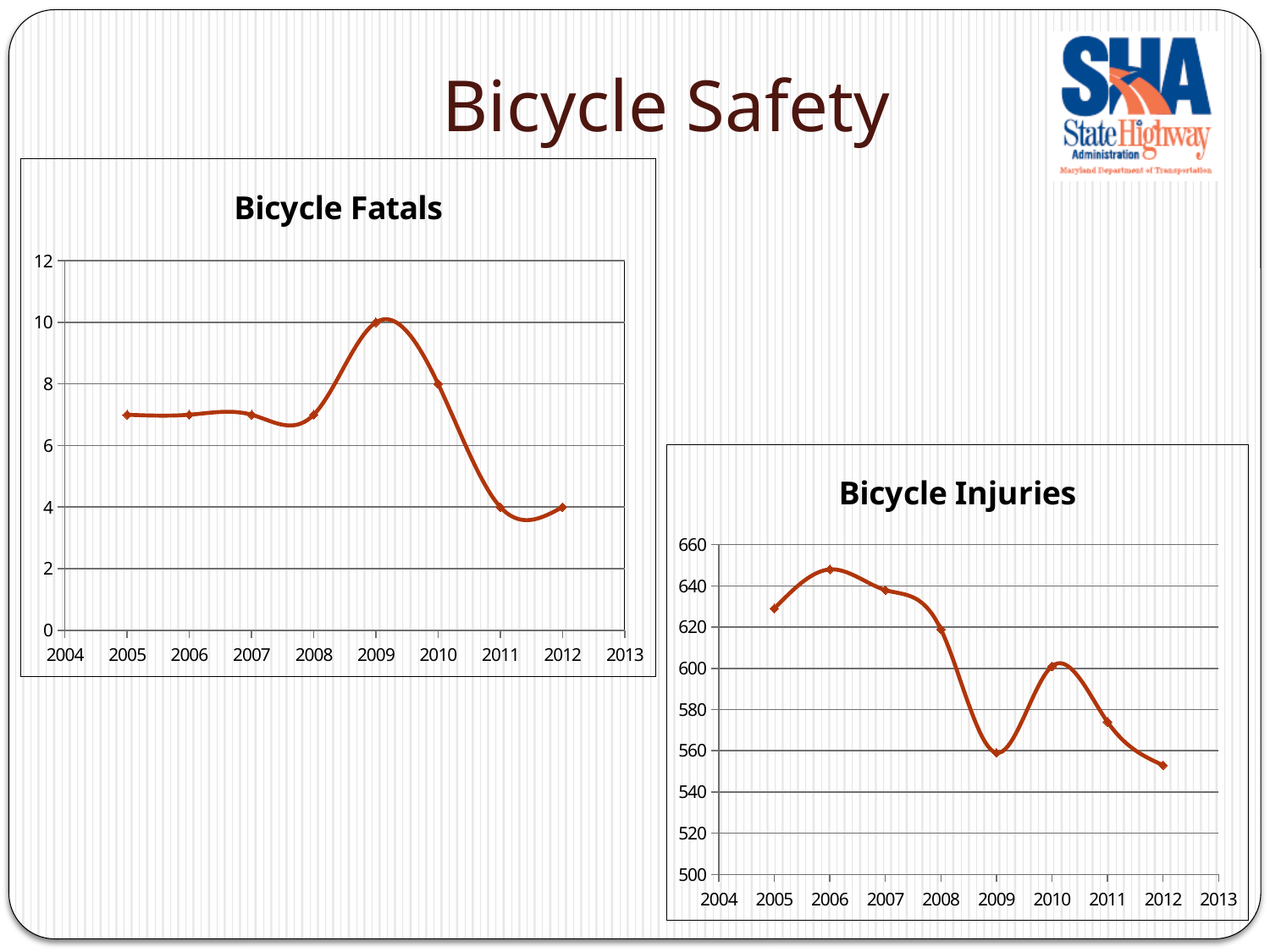
In the Bicycle Fatals chart, how many data points are plotted? 8 In the Bicycle Fatals chart, what is the value for 2012? 4 In the Bicycle Injuries chart, which is larger, the value for 2006 or the value for 2012? 2006 What kind of chart is the Bicycle Injuries chart? line chart In the Bicycle Fatals chart, what is the difference between the values for 2009 and 2012? 6 In the Bicycle Injuries chart, is the value for 2009 greater or less than 580? less In the Bicycle Fatals chart, which year has the highest value? 2009 In the Bicycle Fatals chart, is the value for 2007 greater or less than 6? greater In the Bicycle Injuries chart, which year has the highest value? 2006 In the Bicycle Fatals chart, what is the value for 2009? 10 In the Bicycle Fatals chart, what is the value for 2010? 8 In the Bicycle Injuries chart, is the value for 2005 greater or less than 620? greater